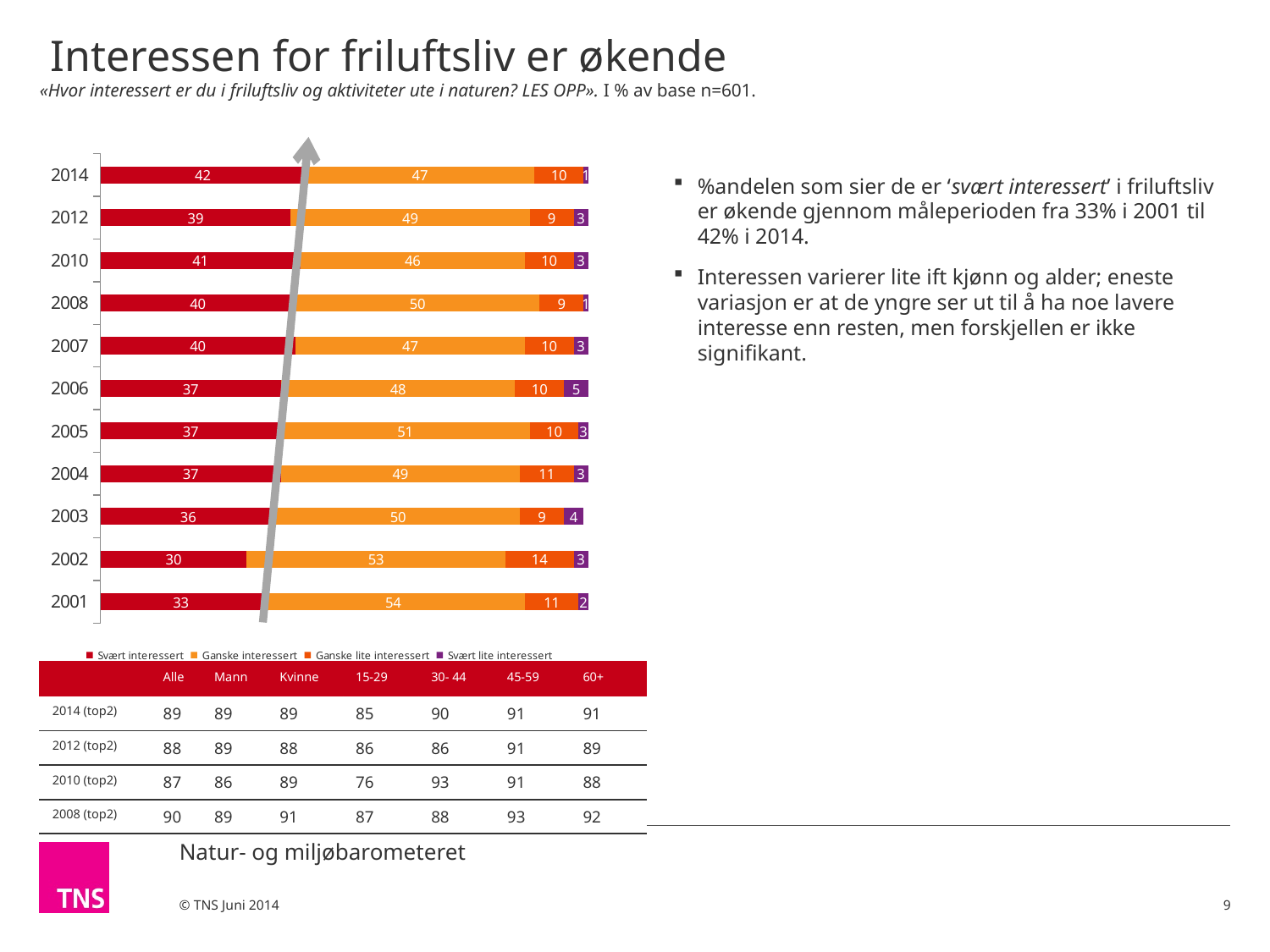
What is the value for 'Ganske lite interessert' in 2002? 14 What is the difference between the 'Svært interessert' values for 2014 and 2001? 9 How many years are shown in the bar chart? 11 What is the value for 'Ganske interessert' in 2001? 54 How many series does the chart legend list? 4 What is the total of the stacked bar for 2014? 100 In which year is the 'Svært interessert' value highest? 2014 What is the value for 'Svært lite interessert' in 2006? 5 What kind of chart is shown on the slide? Stacked bar chart In which year is the 'Svært interessert' value lowest? 2002 Which is larger, the 'Ganske interessert' value for 2002 or for 2010? 2002 What is the value for 'Svært interessert' in 2014? 42